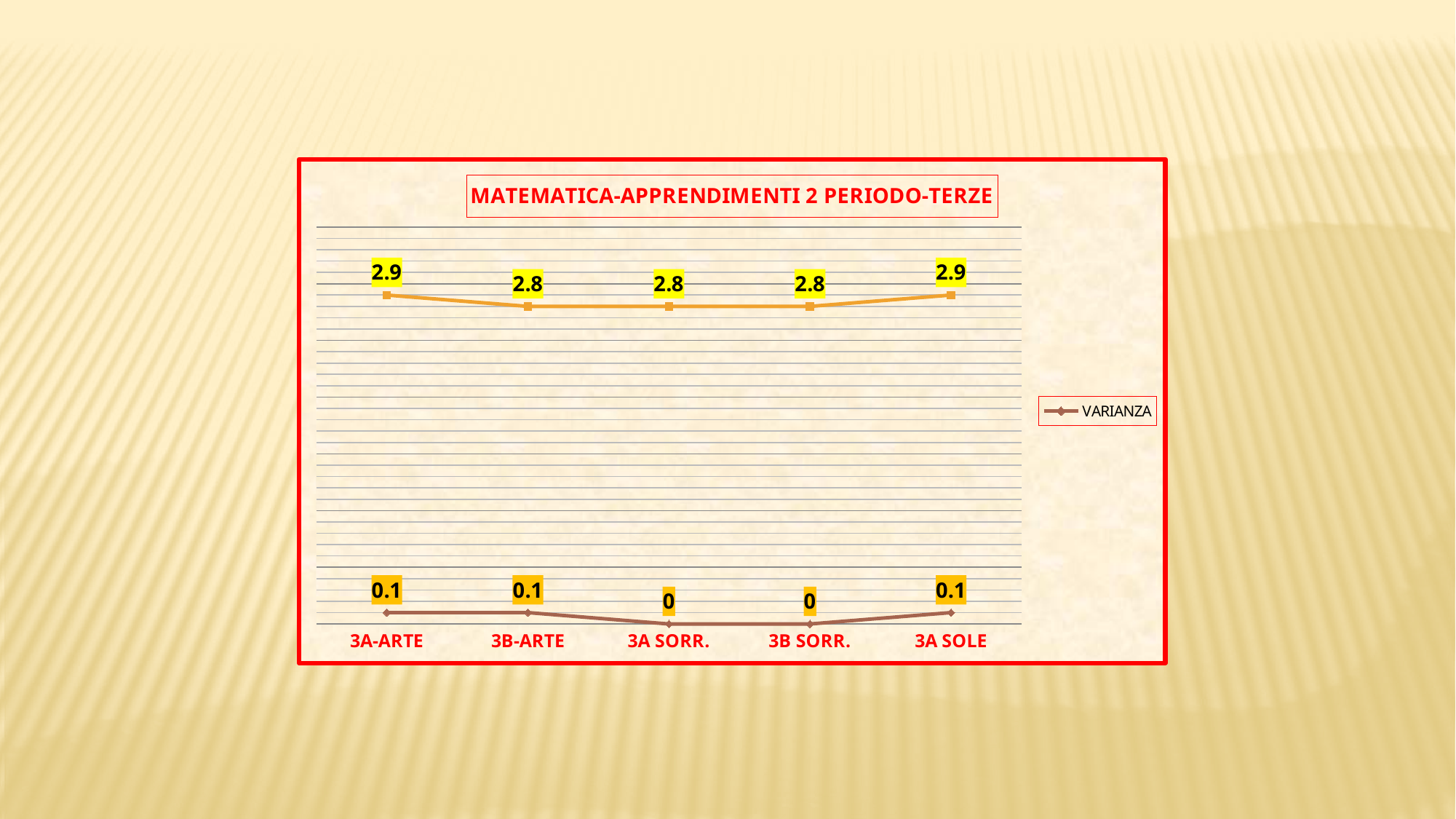
What is the VARIANZA value for 3A SOLE? 0.1 What is the title of the chart? MATEMATICA-APPRENDIMENTI 2 PERIODO-TERZE What is the value of the upper orange line for 3A-ARTE? 2.9 What is the difference between the VARIANZA values for 3B-ARTE and 3B SORR.? 0.1 Which categories have a VARIANZA value of 0? 3A SORR. and 3B SORR. How many series does the chart's legend list? 1 What kind of chart is shown on the slide? line chart What is the value of the upper orange line for 3B SORR.? 2.8 What series name appears in the chart's legend? VARIANZA What is the VARIANZA value for 3A SORR.? 0 What is the VARIANZA value for 3A-ARTE? 0.1 How many categories are shown on the x axis of the chart? 5